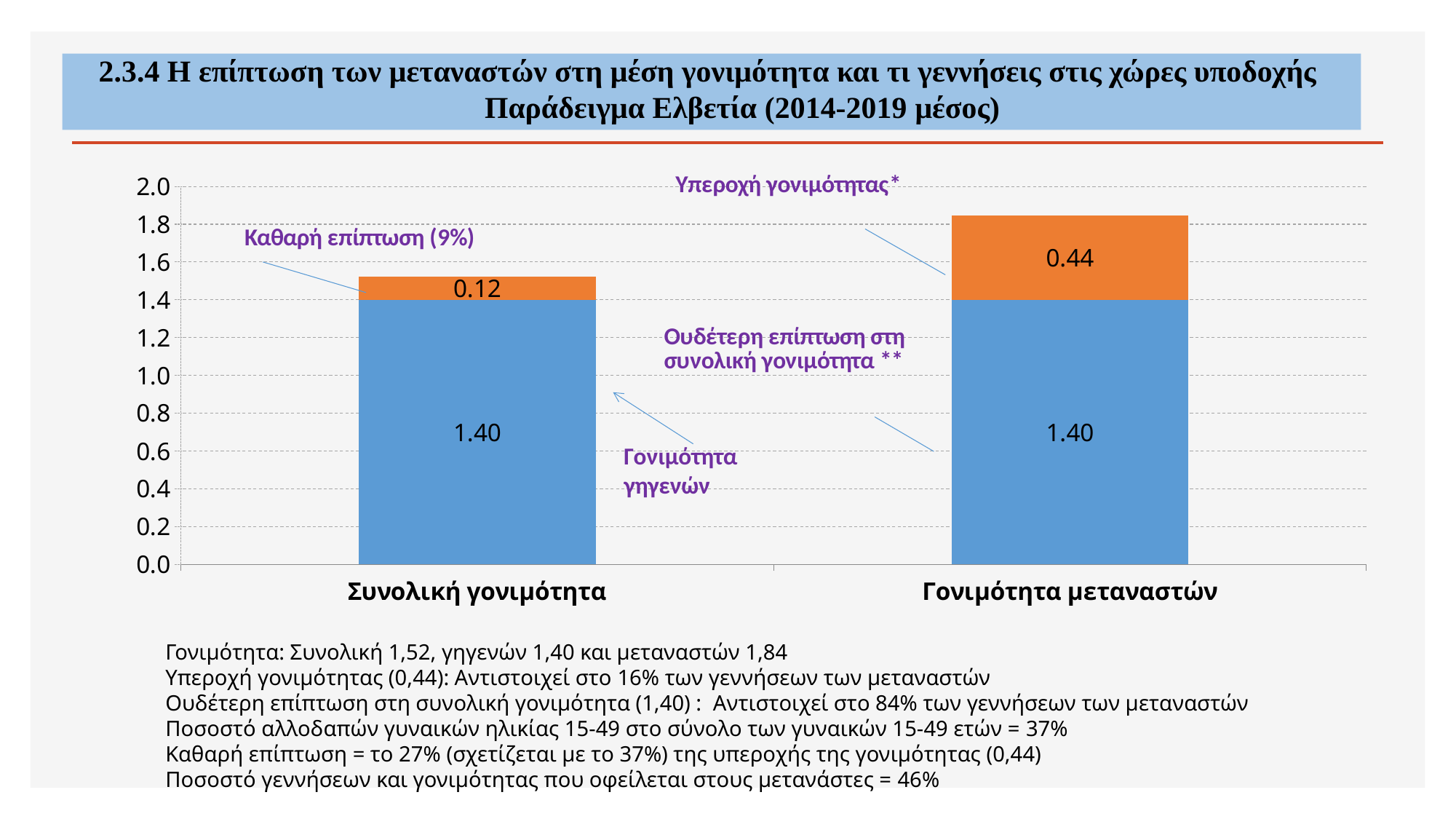
How many categories are shown on the x axis of the chart? 2 What is the value of the orange segment for Γονιμότητα μεταναστών? 0.44 Which category has the taller stacked bar? Γονιμότητα μεταναστών What is the total of the stacked bar for Συνολική γονιμότητα? 1.52 What is the total of the stacked bar for Γονιμότητα μεταναστών? 1.84 What is the value of the blue segment for Γονιμότητα μεταναστών? 1.40 What is the difference between the orange segments of Γονιμότητα μεταναστών and Συνολική γονιμότητα? 0.32 What is the value of the orange segment for Συνολική γονιμότητα? 0.12 What kind of chart is shown on the slide? bar chart Which orange segment is larger, Συνολική γονιμότητα or Γονιμότητα μεταναστών? Γονιμότητα μεταναστών Is the total of the Συνολική γονιμότητα bar greater or less than 1.6? less What is the value of the blue segment for Συνολική γονιμότητα? 1.40